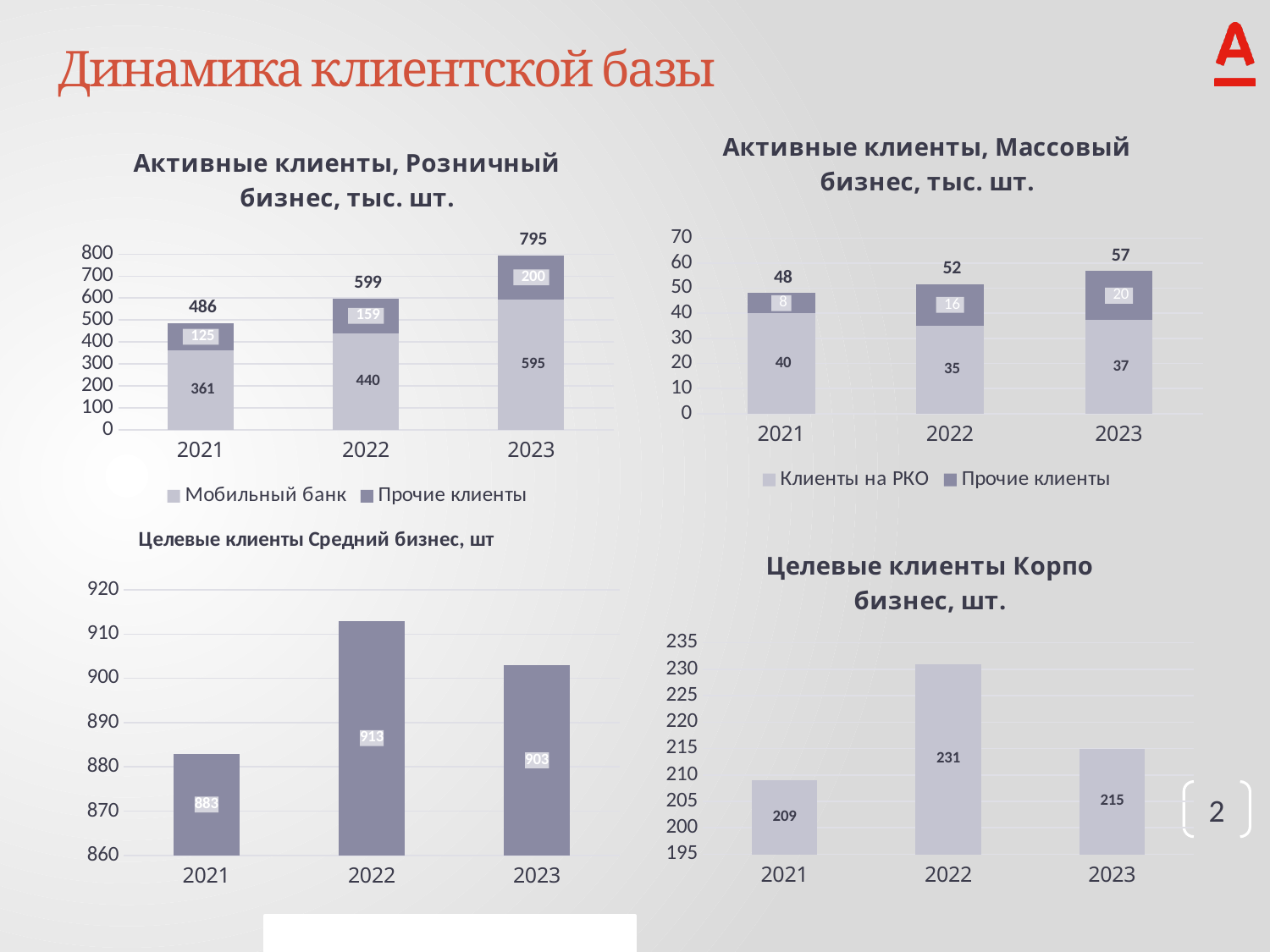
In the chart 'Активные клиенты, Розничный бизнес, тыс. шт.', what is the value of 'Мобильный банк' for 2022? 440 In the chart 'Активные клиенты, Массовый бизнес, тыс. шт.', what is the value of 'Клиенты на РКО' for 2021? 40 In the chart 'Активные клиенты, Массовый бизнес, тыс. шт.', how many series does the legend list? 2 What kind of chart is 'Целевые клиенты Корпо бизнес, шт.'? bar chart In the chart 'Активные клиенты, Массовый бизнес, тыс. шт.', which year has the lowest total value? 2021 In the chart 'Целевые клиенты Корпо бизнес, шт.', which is larger, the value for 2021 or the value for 2023? 2023 In the chart 'Активные клиенты, Розничный бизнес, тыс. шт.', do the total values rise or fall from 2021 to 2023? rise In the chart 'Целевые клиенты Средний бизнес, шт', which year has the highest value? 2022 In the chart 'Активные клиенты, Розничный бизнес, тыс. шт.', what is the difference between the 'Прочие клиенты' values for 2023 and 2021? 75 In the chart 'Целевые клиенты Средний бизнес, шт', what is the difference between the values for 2022 and 2021? 30 In the chart 'Целевые клиенты Корпо бизнес, шт.', what is the value for 2023? 215 In the chart 'Активные клиенты, Розничный бизнес, тыс. шт.', what is the total value for 2023? 795